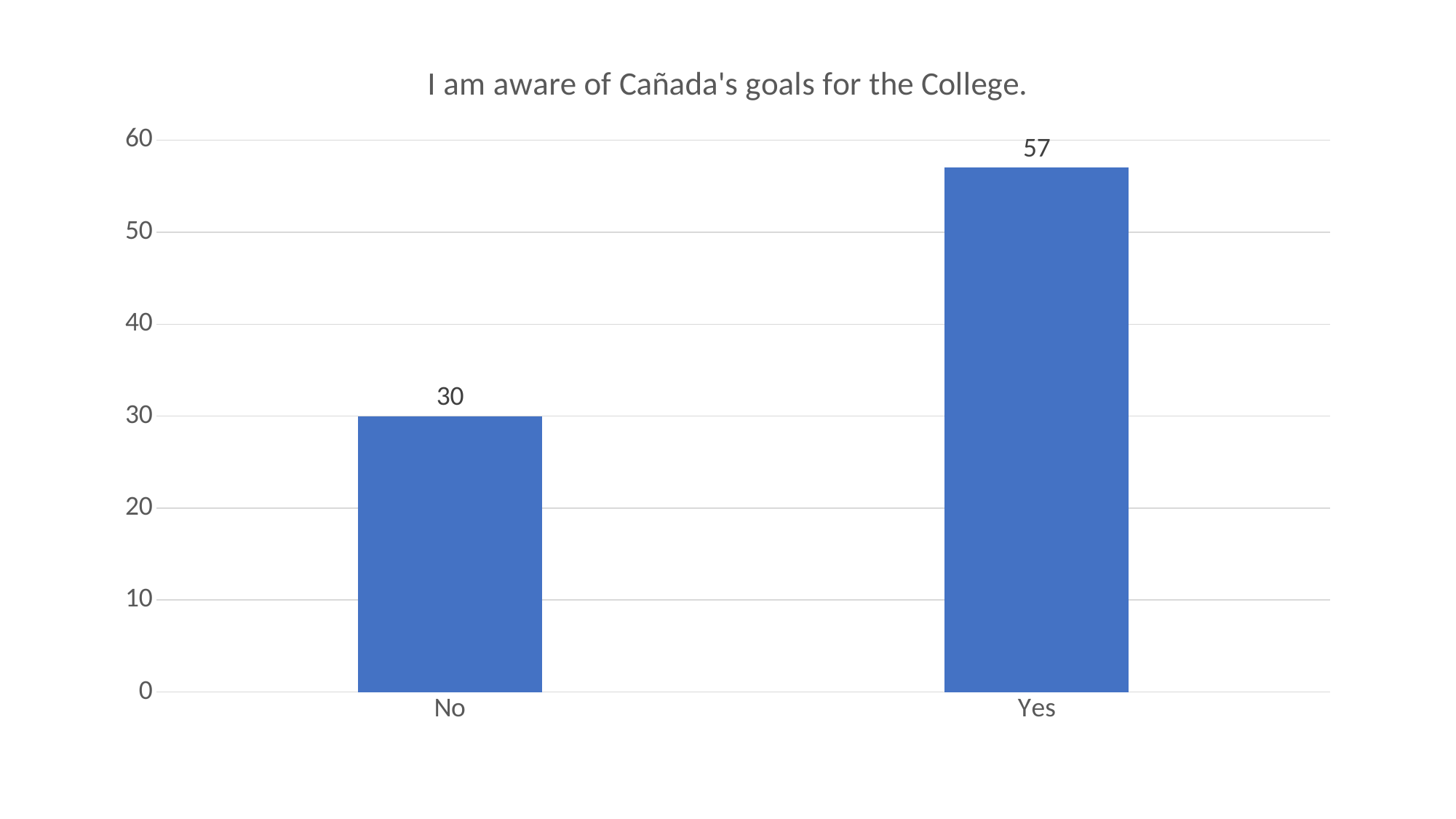
What is the highest value shown on the y axis? 60 Is the value for "Yes" greater or less than 50? greater What is the title of the chart? I am aware of Cañada's goals for the College. What kind of chart is shown on the slide? bar chart Is the value for "No" greater or less than 40? less Which is larger, the value for "Yes" or the value for "No"? Yes Which category has the lowest value? No What is the difference between the values for "Yes" and "No"? 27 How many categories are shown on the x axis? 2 What is the value for "Yes"? 57 Which category has the highest value? Yes What is the value for "No"? 30